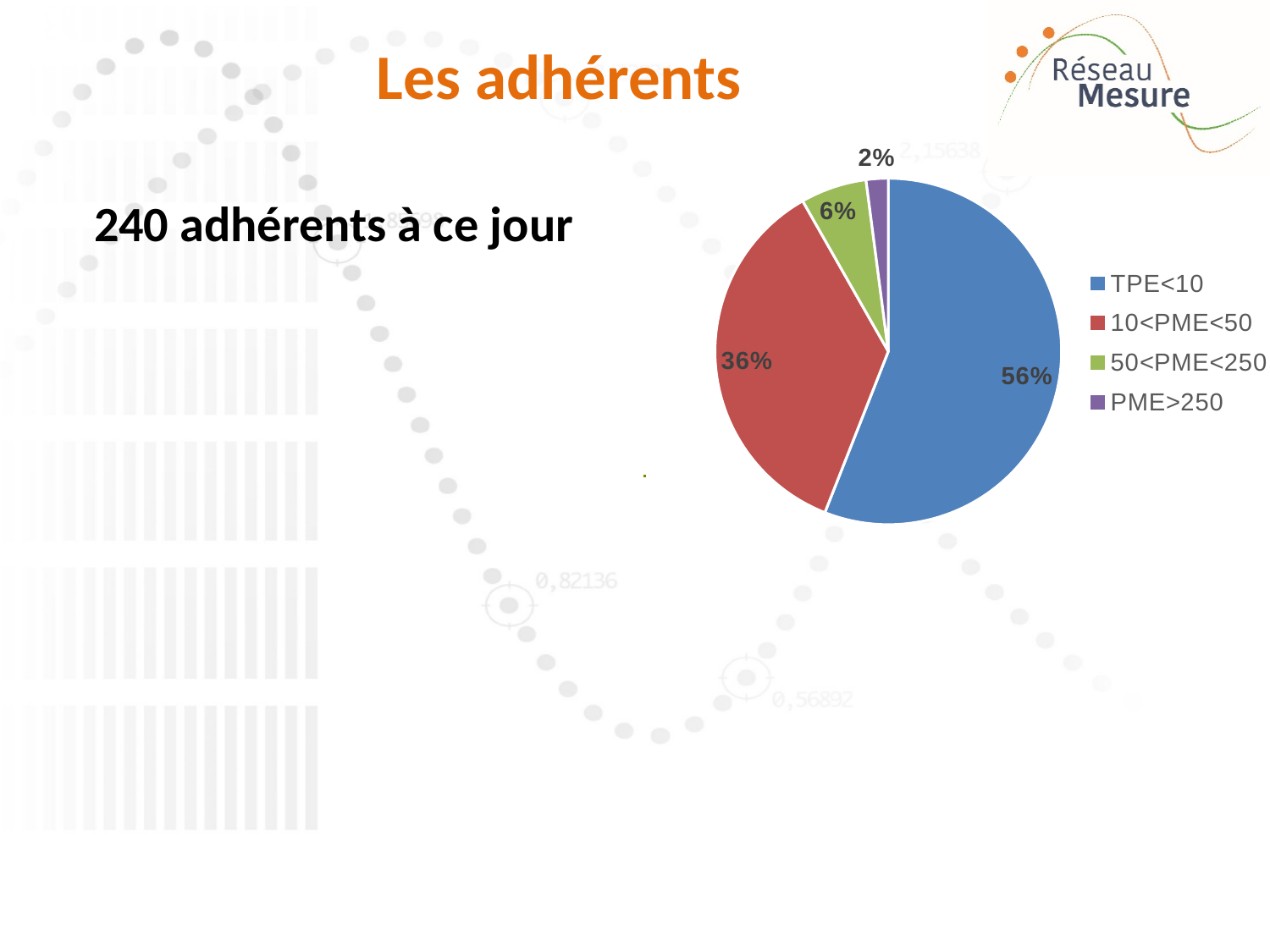
What is the difference in percentage points between the TPE<10 slice and the 10<PME<50 slice? 20 Which category has the largest slice of the pie? TPE<10 What share of the pie does 50<PME<250 represent? 6% What share of the pie does 10<PME<50 represent? 36% What is the combined share of the 50<PME<250 and PME>250 slices? 8% How many categories are shown in the pie chart? 4 What kind of chart is shown on the slide? Pie chart What colour is the slice for 10<PME<50? Red What share of the pie does TPE<10 represent? 56% Which category has the smallest slice of the pie? PME>250 Which slice is larger, 50<PME<250 or PME>250? 50<PME<250